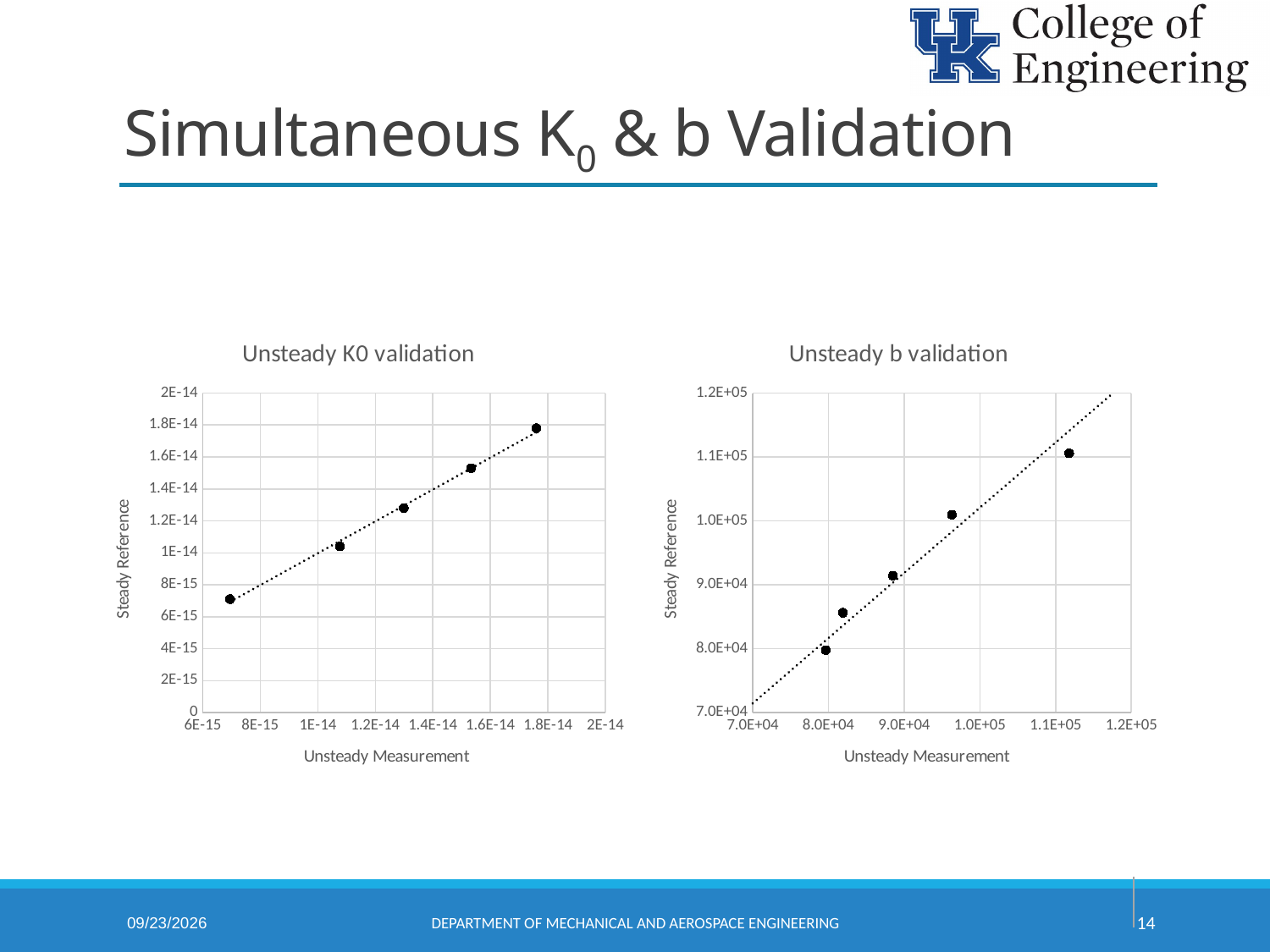
In the 'Unsteady b validation' chart, do the Steady Reference values rise or fall as Unsteady Measurement increases? rise In the 'Unsteady b validation' chart, is the Steady Reference value of the highest point greater or less than 1.0E+05? greater In the 'Unsteady K0 validation' chart, do the Steady Reference values rise or fall as Unsteady Measurement increases? rise How many data points are plotted in the 'Unsteady b validation' chart? 5 What kind of chart is the 'Unsteady K0 validation' chart? scatter chart In the 'Unsteady K0 validation' chart, is the Steady Reference value of the lowest point greater or less than 8E-15? less How many data points are plotted in the 'Unsteady K0 validation' chart? 5 What is the x-axis title of the 'Unsteady b validation' chart? Unsteady Measurement What is the y-axis title of the 'Unsteady K0 validation' chart? Steady Reference In the 'Unsteady K0 validation' chart, is the Steady Reference value of the highest point greater or less than 1.6E-14? greater What kind of chart is the 'Unsteady b validation' chart? scatter chart